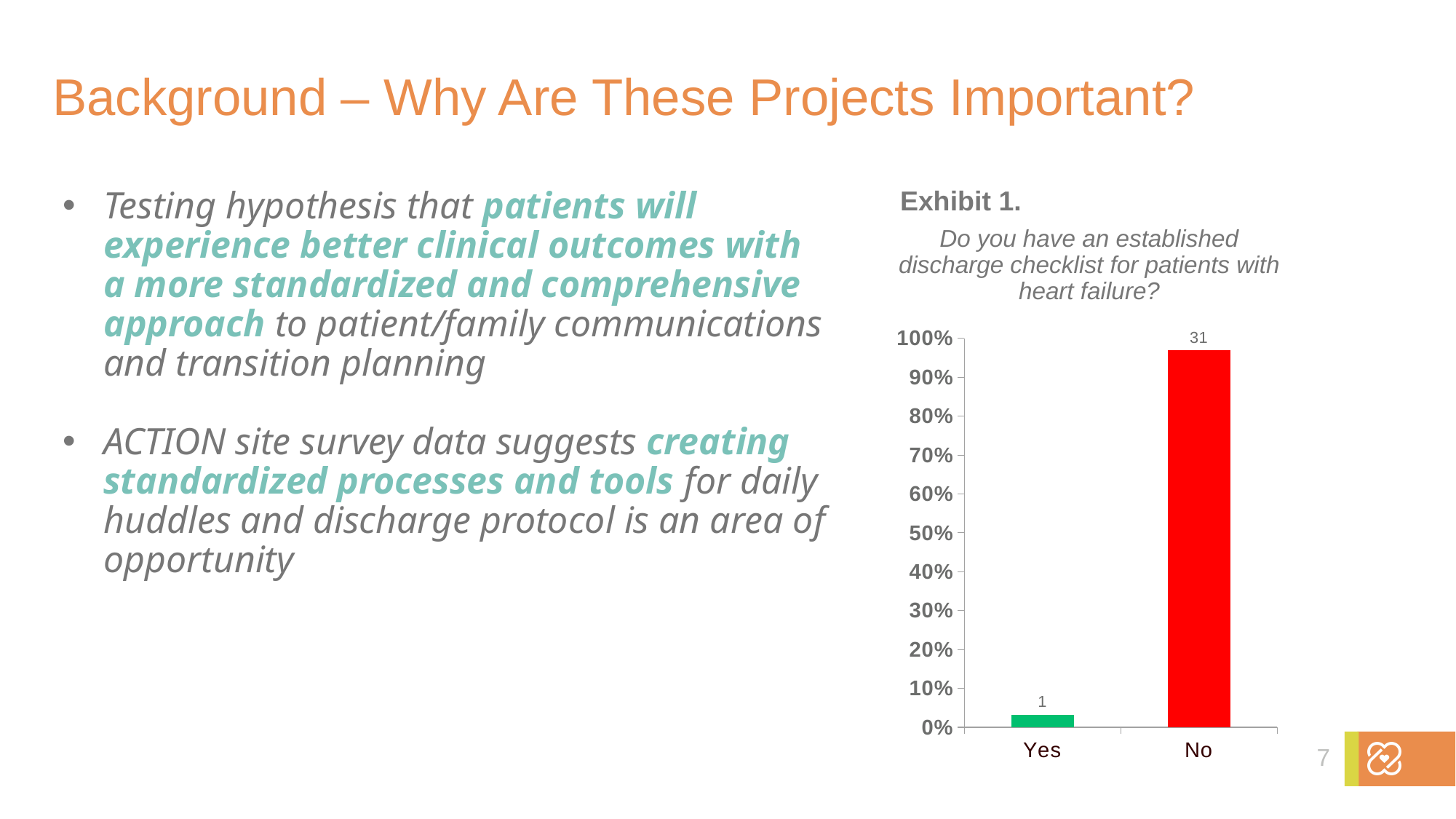
How many categories are shown on the x axis of the Exhibit 1 chart? 2 What question does the Exhibit 1 chart title ask? Do you have an established discharge checklist for patients with heart failure? Which category has the highest bar in Exhibit 1? No What data label is printed above the "No" bar in Exhibit 1? 31 What data label is printed above the "Yes" bar in Exhibit 1? 1 What type of chart is shown in Exhibit 1? bar chart Which category has the lowest bar in Exhibit 1? Yes What is the difference between the data labels on the "No" and "Yes" bars in Exhibit 1? 30 In Exhibit 1, which bar is taller, "Yes" or "No"? No What colour is the "No" bar in Exhibit 1? red Is the value for "Yes" in Exhibit 1 greater or less than 10%? less Is the value for "No" in Exhibit 1 greater or less than 90%? greater